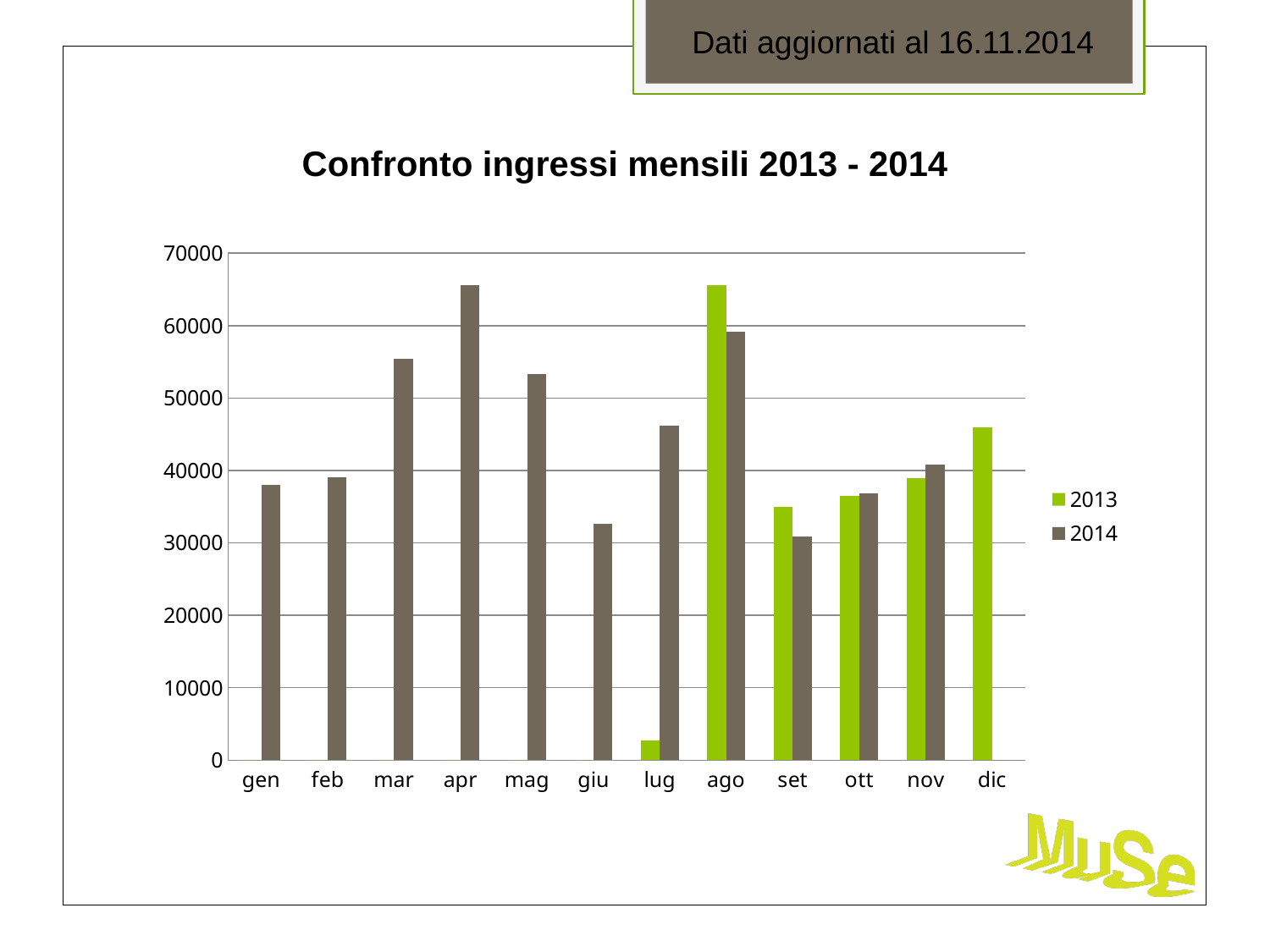
In ago, which series has the larger value, 2013 or 2014? 2013 Is the 2014 value for apr greater or less than 60000? greater Which month has the highest value for the 2014 series? apr In set, which series has the larger value, 2013 or 2014? 2013 How many series does the legend list? 2 Which month has the highest value for the 2013 series? ago What is the title of the chart? Confronto ingressi mensili 2013 - 2014 Which month has the lowest value for the 2013 series? lug What kind of chart is shown on the slide? bar chart Is the 2013 value for lug greater or less than 10000? less How many months are shown on the x axis? 12 Which month has the lowest value for the 2014 series among the months where 2014 is plotted? set